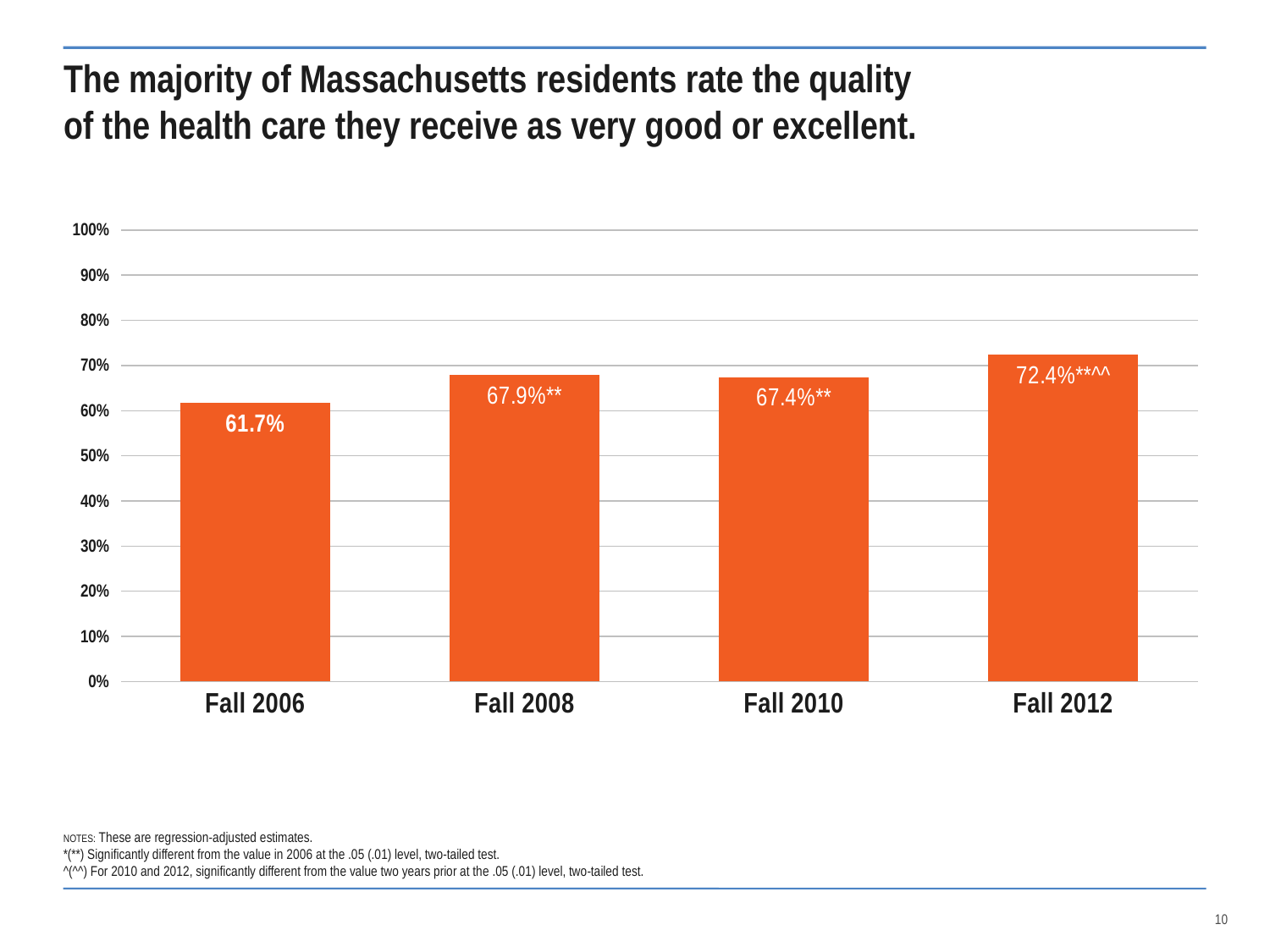
What is the value for Fall 2008? 67.9% Which is larger, the value for Fall 2010 or the value for Fall 2006? Fall 2010 Do the values generally rise or fall from Fall 2006 to Fall 2012? Rise What colour are the bars in the chart? Orange Which period has the lowest value? Fall 2006 What is the difference between the Fall 2012 and Fall 2006 values? 10.7 percentage points How many periods are shown on the x axis? 4 Is the value for Fall 2012 greater or less than 70%? greater What kind of chart is shown on the slide? Bar chart Which period has the highest value? Fall 2012 What is the value for Fall 2012? 72.4% What is the value for Fall 2006? 61.7%